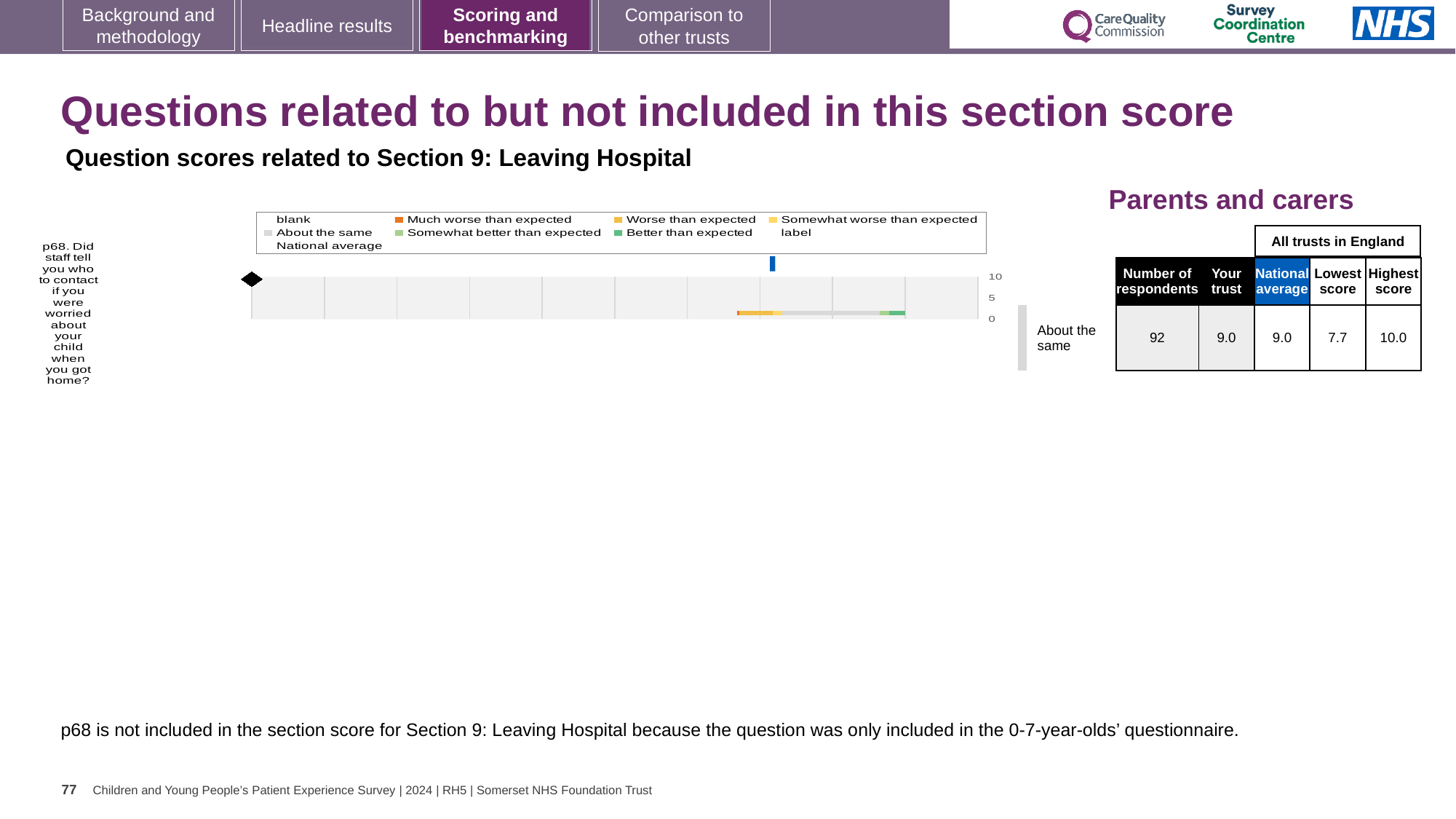
What is the highest tick value shown on the chart's axis? 10 What is the national average score for p68? 9.0 How many respondents answered p68? 92 What is the lowest score among all trusts in England for p68? 7.7 Which question number is plotted in the chart? p68 What kind of chart is shown on the slide? bar chart What is the difference between the highest score and the lowest score for p68? 2.3 What is the 'Your trust' score for p68? 9.0 How many survey questions are plotted in the chart? 1 What benchmark category label is shown next to the chart for p68? About the same What is the highest score among all trusts in England for p68? 10.0 How many entries does the chart legend list? 9